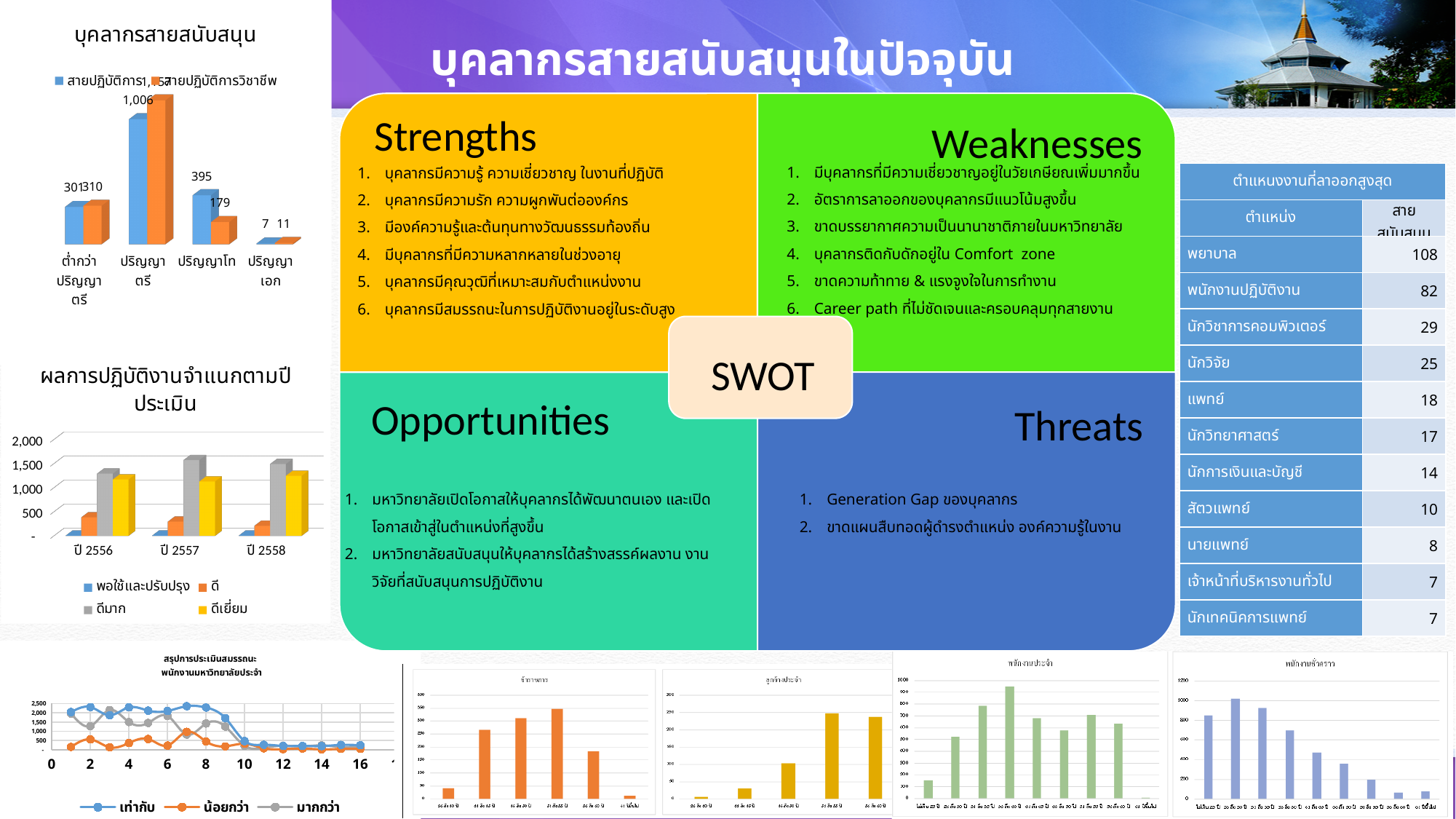
In the chart titled บุคลากรสายสนับสนุน, what is the value for สายปฏิบัติการ in the ปริญญาตรี category? 1,006 In the chart titled ผลการปฏิบัติงานจำแนกตามปีประเมิน, how many series does the legend list? 4 In the chart titled บุคลากรสายสนับสนุน, what is the value for สายปฏิบัติการวิชาชีพ in the ปริญญาโท category? 179 In the line chart at the bottom left titled สรุปการประเมินสมรรถนะพนักงานมหาวิทยาลัยประจำ, how many series does the legend list? 3 In the chart titled บุคลากรสายสนับสนุน, how many categories are shown on the x axis? 4 In the chart titled ผลการปฏิบัติงานจำแนกตามปีประเมิน, is the value for ดีมาก in ปี 2557 greater or less than 1,000? greater In the chart titled บุคลากรสายสนับสนุน, which series has the larger value in the ต่ำกว่าปริญญาตรี category? สายปฏิบัติการวิชาชีพ In the chart titled บุคลากรสายสนับสนุน, what is the difference between the สายปฏิบัติการ and สายปฏิบัติการวิชาชีพ values for ปริญญาโท? 216 What kind of chart is the one titled ผลการปฏิบัติงานจำแนกตามปีประเมิน? bar chart In the chart titled บุคลากรสายสนับสนุน, what is the value for สายปฏิบัติการ in the ปริญญาโท category? 395 In the chart titled บุคลากรสายสนับสนุน, what is the value for สายปฏิบัติการวิชาชีพ in the ปริญญาเอก category? 11 In the chart titled บุคลากรสายสนับสนุน, which category has the lowest value for สายปฏิบัติการ? ปริญญาเอก